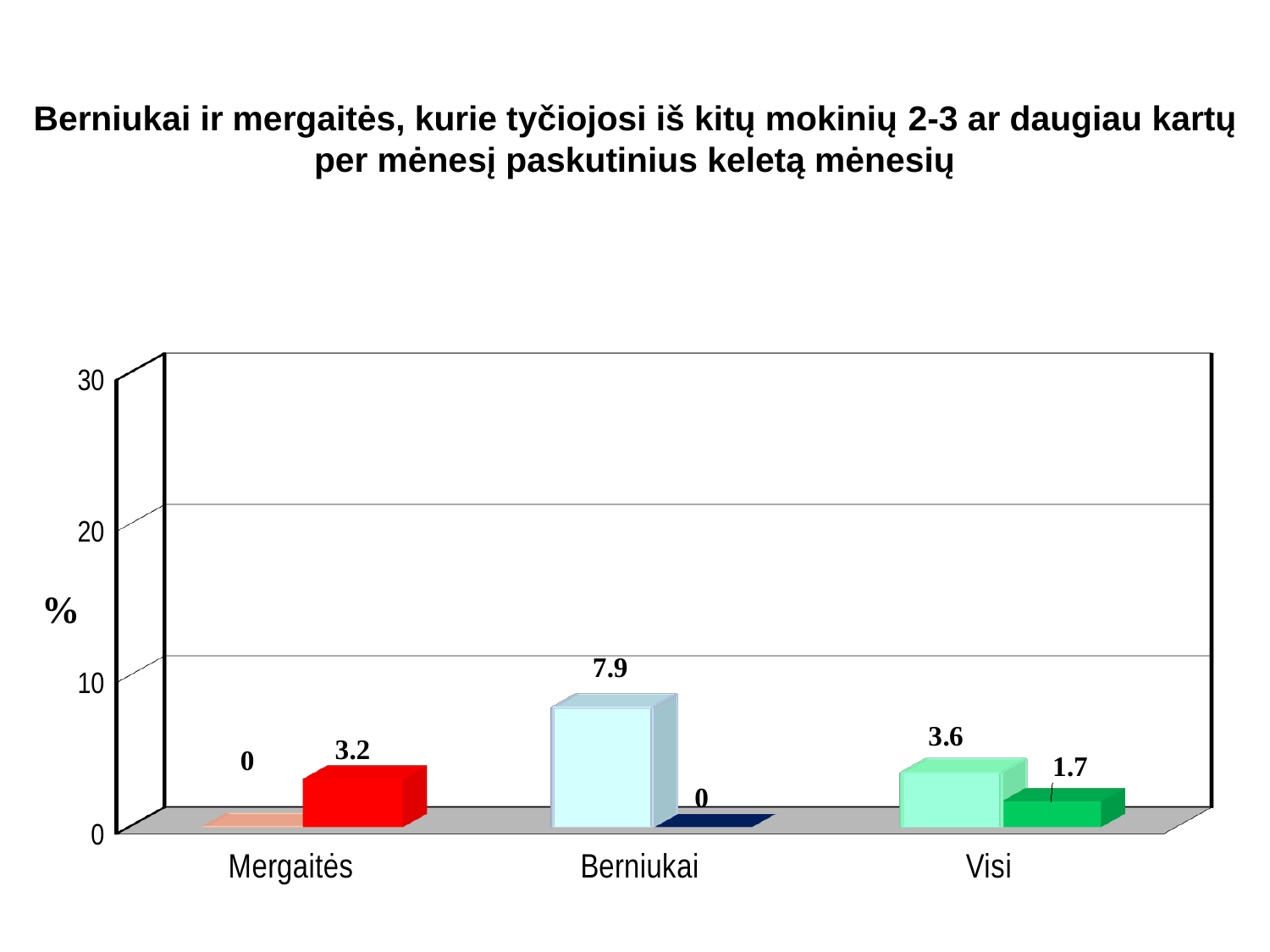
What is the value of the first bar for Mergaitės? 0 What is the value of the first (light blue) bar for Berniukai? 7.9 What type of chart is shown on the slide? bar chart What is the difference between the two bars for Visi (3.6 and 1.7)? 1.9 What is the value of the first (light green) bar for Visi? 3.6 Which is larger: the first bar for Berniukai or the first bar for Visi? Berniukai What is the value of the second (red) bar for Mergaitės? 3.2 Is the value of the first bar for Berniukai greater or less than 10? less What label is shown on the vertical axis? % What is the value of the second (dark green) bar for Visi? 1.7 How many categories are shown on the x axis? 3 Which category has the highest bar in the chart? Berniukai